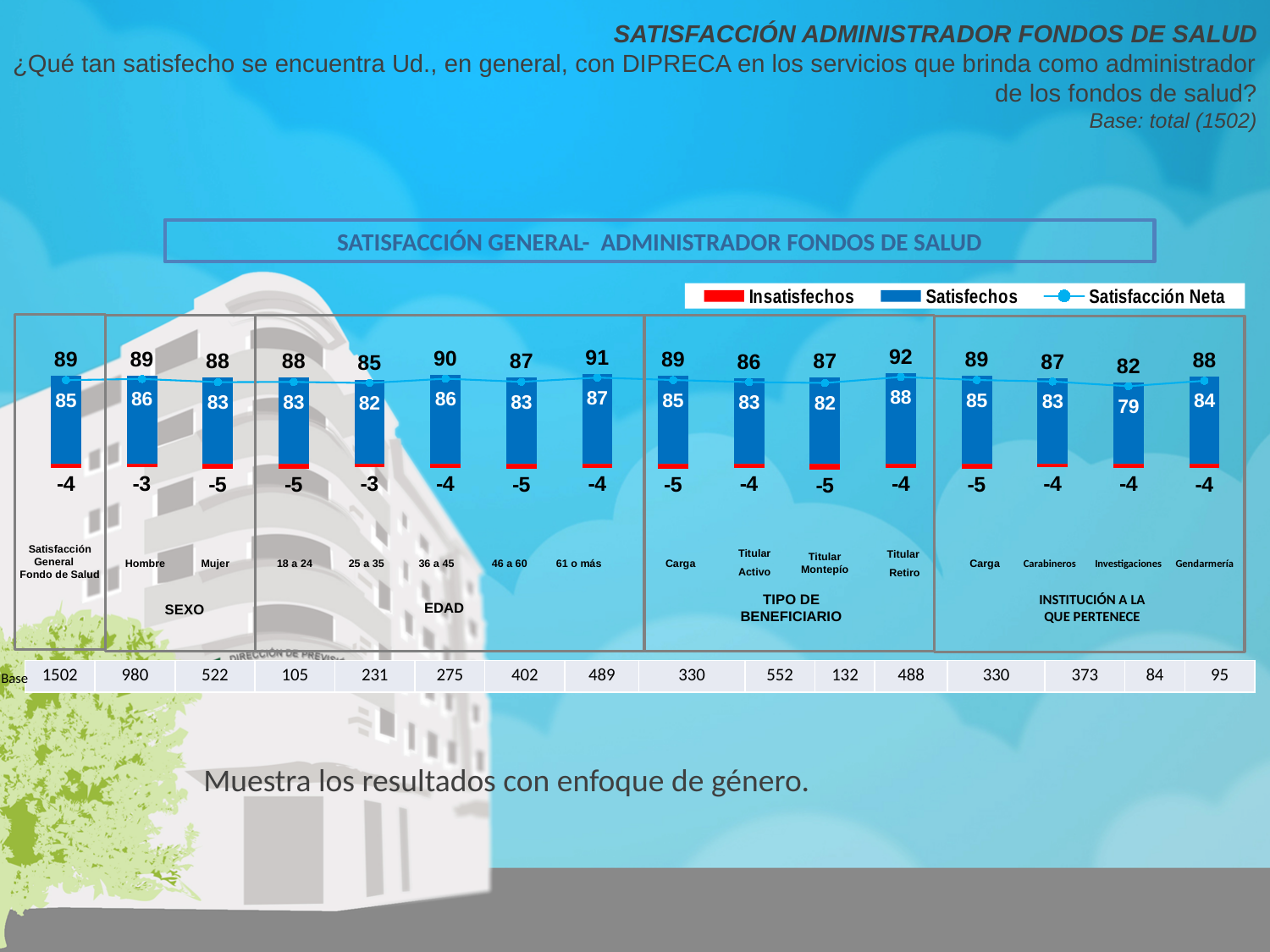
Which category has the lowest Satisfacción Neta value? Investigaciones Which series in the legend is shown in red? Insatisfechos What is the Insatisfechos value for Hombre? -3 What is the Satisfacción Neta value for Titular Retiro? 88 Which has a higher Satisfechos value, Gendarmería or Carabineros? Gendarmería What is the difference between the Satisfechos values for Titular Retiro and Titular Montepío? 5 What kind of chart is shown on the slide? Bar chart with a line Which category has the highest Satisfacción Neta value? Titular Retiro What is the difference between the Satisfacción Neta values for Hombre and Mujer? 3 What is the Satisfechos value for the 61 o más age group? 91 How many series does the legend list? 3 What is the Satisfechos value for Investigaciones? 82